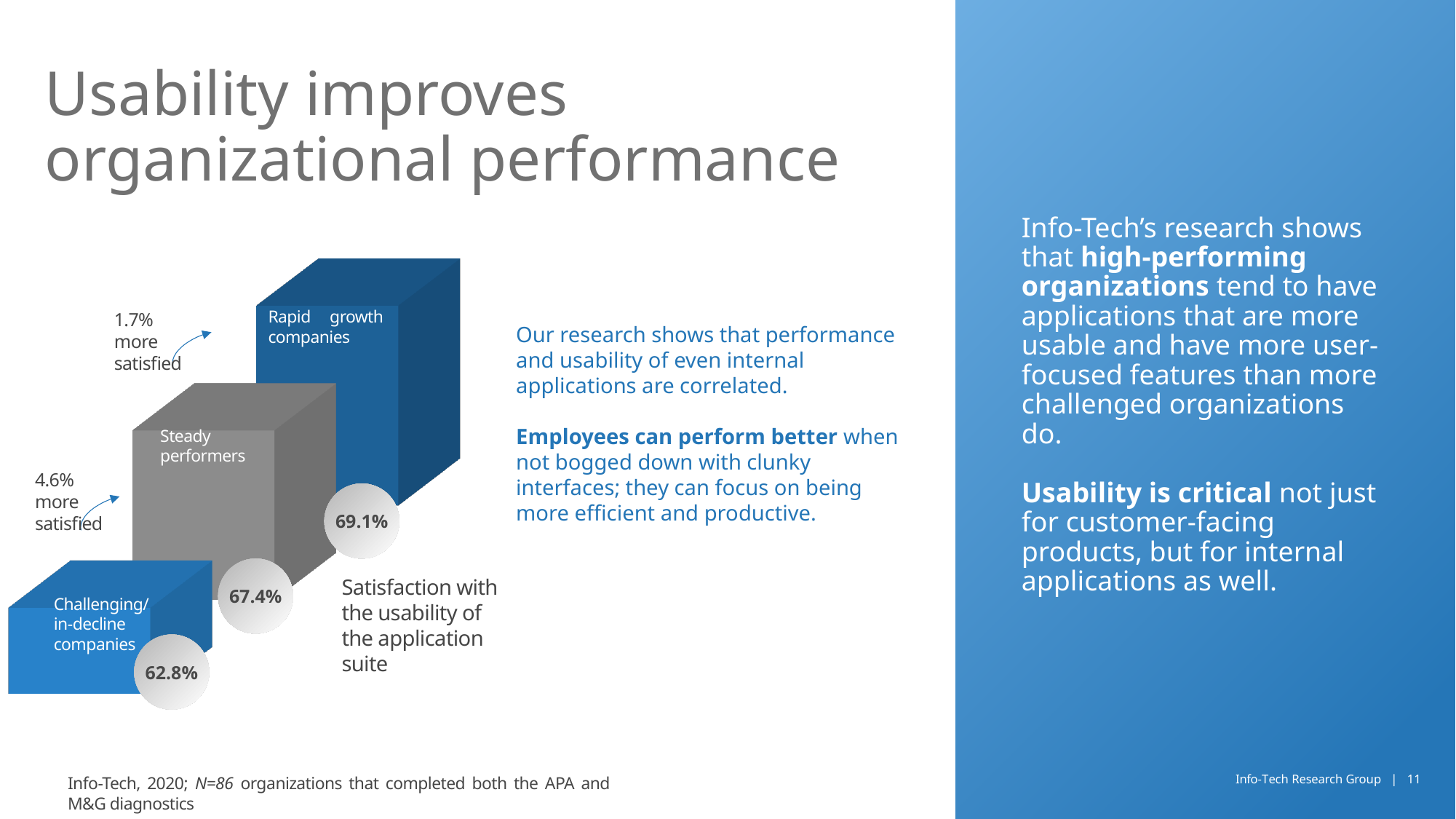
Do the satisfaction values rise or fall from challenging/in-decline companies to rapid growth companies? Rise What is the difference in satisfaction between rapid growth companies and steady performers? 1.7% Which has a higher satisfaction value, steady performers or rapid growth companies? Rapid growth companies Which category has the lowest satisfaction with the usability of the application suite? Challenging/in-decline companies What is the satisfaction with the usability of the application suite for rapid growth companies? 69.1% What is the satisfaction with the usability of the application suite for challenging/in-decline companies? 62.8% What measure does the chart show for each company category? Satisfaction with the usability of the application suite What kind of chart is shown on the slide? Bar chart What is the difference in satisfaction between steady performers and challenging/in-decline companies? 4.6% How many company categories are shown in the chart? 3 What is the satisfaction with the usability of the application suite for steady performers? 67.4% Which category has the highest satisfaction with the usability of the application suite? Rapid growth companies